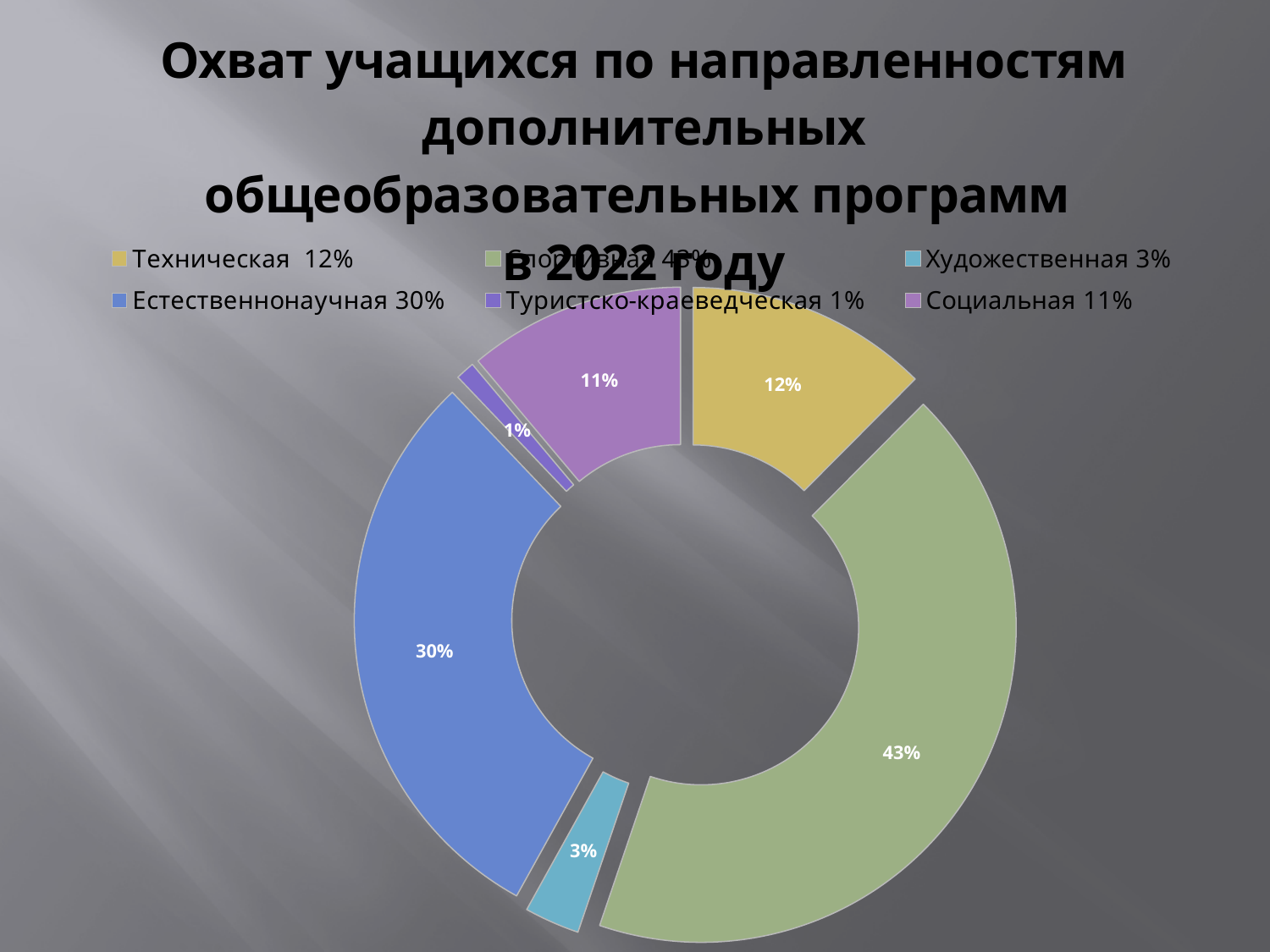
How many categories does the chart show? 6 What kind of chart is shown on the slide? doughnut chart What percentage is shown for Художественная? 3% What percentage is shown for Естественнонаучная? 30% Which category has the smallest share of the chart? Туристско-краеведческая What is the difference between the shares of Естественнонаучная and Техническая? 18% What percentage is shown for Социальная? 11% What percentage is shown for Туристско-краеведческая? 1% Which category has the largest share of the chart? Спортивная What percentage is shown for Техническая? 12% What colour is the slice for Естественнонаучная? blue Which is larger, the share of Социальная or the share of Техническая? Техническая